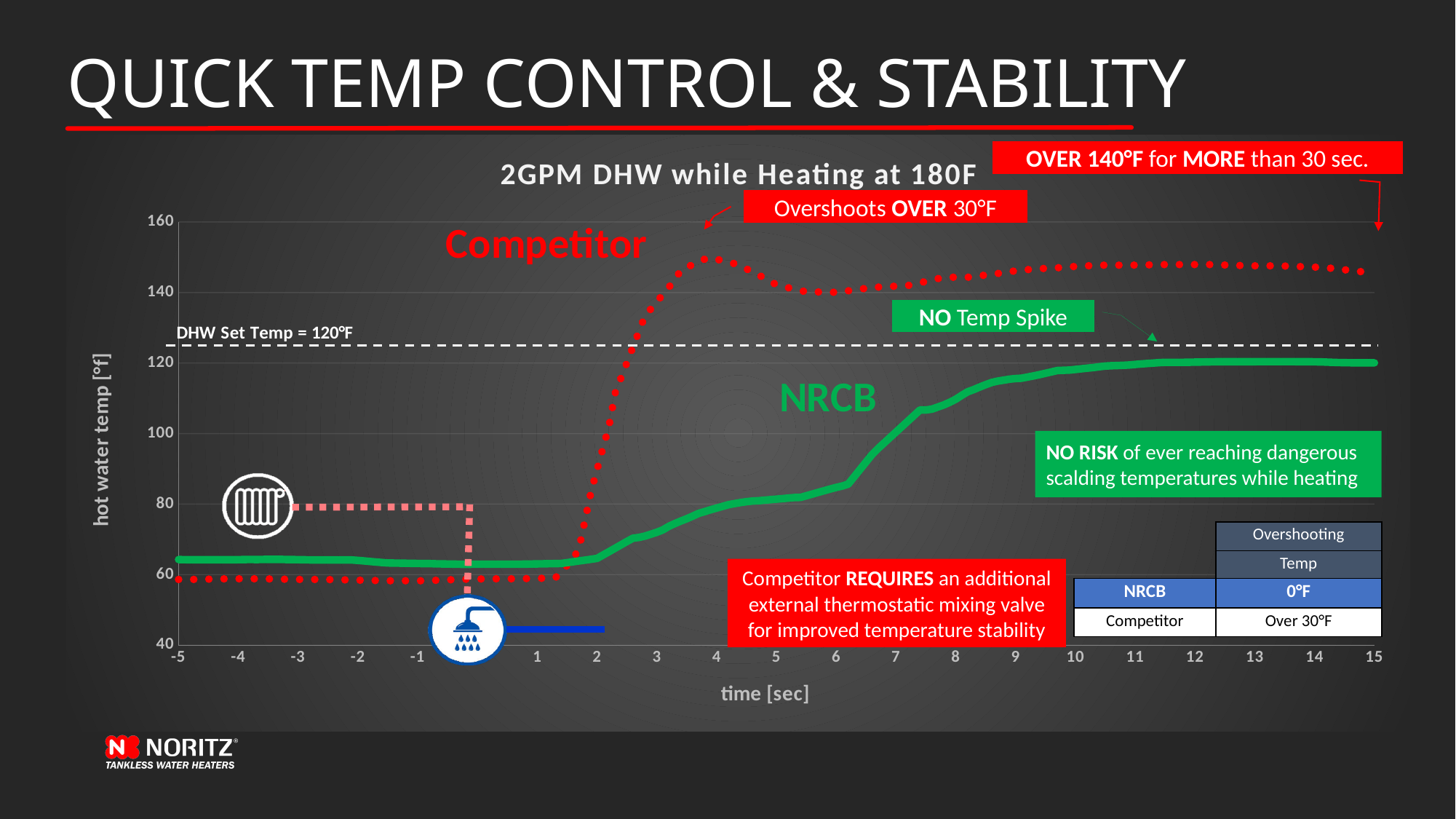
Is the peak value of the Competitor series (around 4 sec) greater or less than 140? greater Does the NRCB series rise or fall between 0 sec and 15 sec? rise What is the label of the y axis? hot water temp [°F] What kind of chart is shown on the slide? line chart What is the title of the chart? 2GPM DHW while Heating at 180F Is the value of the NRCB series at 10 sec greater or less than 100? greater Is the value of the NRCB series at 0 sec greater or less than 80? less How many series are plotted on the chart? 2 According to the Overshooting Temp table, what is the overshooting temperature for NRCB? 0°F Which series reaches the highest hot water temperature on the chart? Competitor At 10 sec, which series has the higher hot water temperature, Competitor or NRCB? Competitor